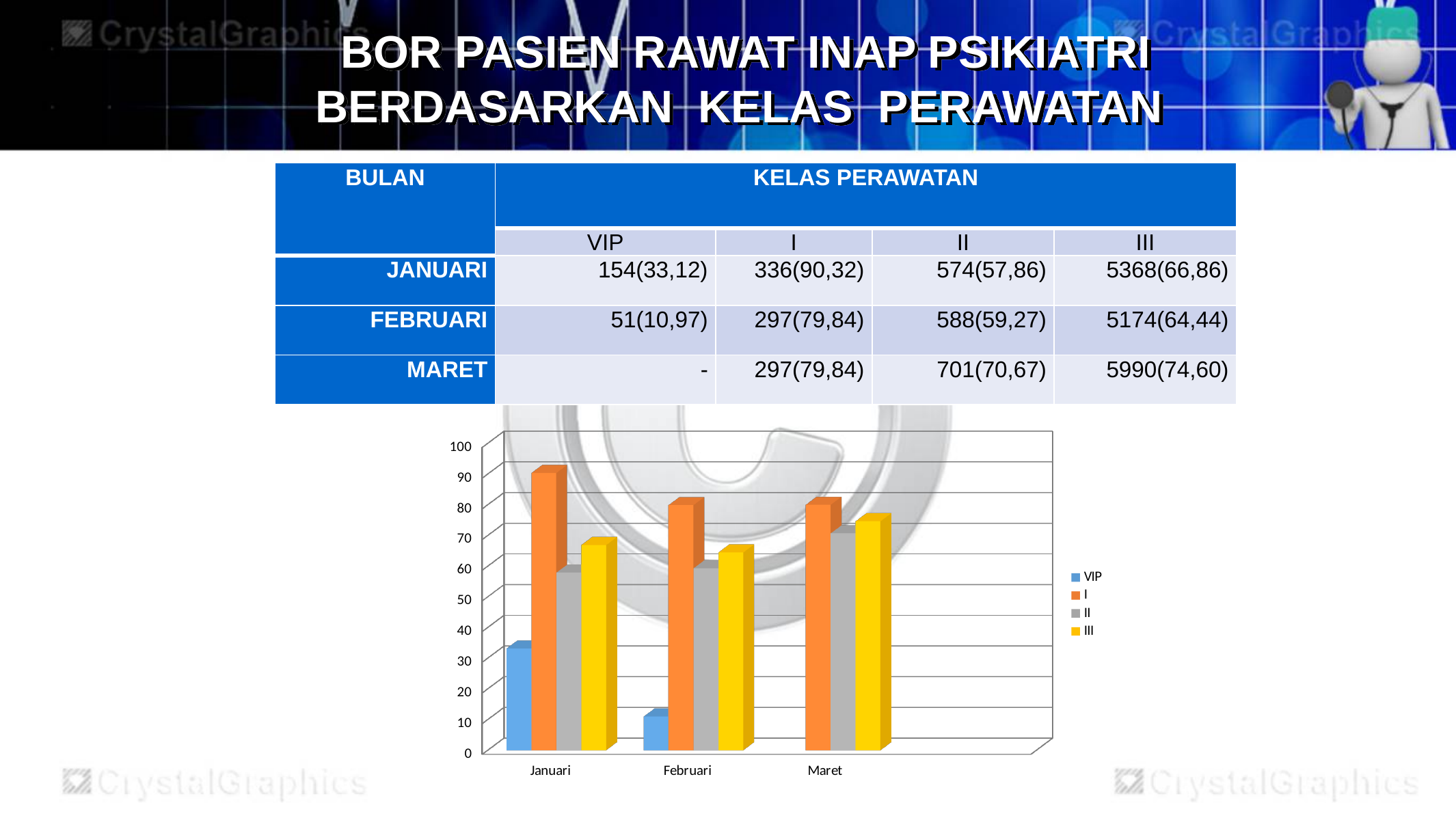
Is the value for class I in Januari greater or less than 80? greater Is the value for VIP in Januari greater or less than 40? less What kind of chart is shown below the table? bar chart Which is larger in the chart: class II in Maret or class II in Februari? class II in Maret How many series does the chart legend list? 4 In the chart, which class has the tallest bar for Januari? I In the chart, which class has the shortest bar for Januari? VIP Which series has no bar plotted for Maret? VIP Is the value for VIP in Februari greater or less than 20? less Do the VIP bars rise or fall from Januari to Februari? fall How many months are shown on the x axis of the chart? 3 Which is larger in the chart: class I in Januari or class I in Februari? class I in Januari